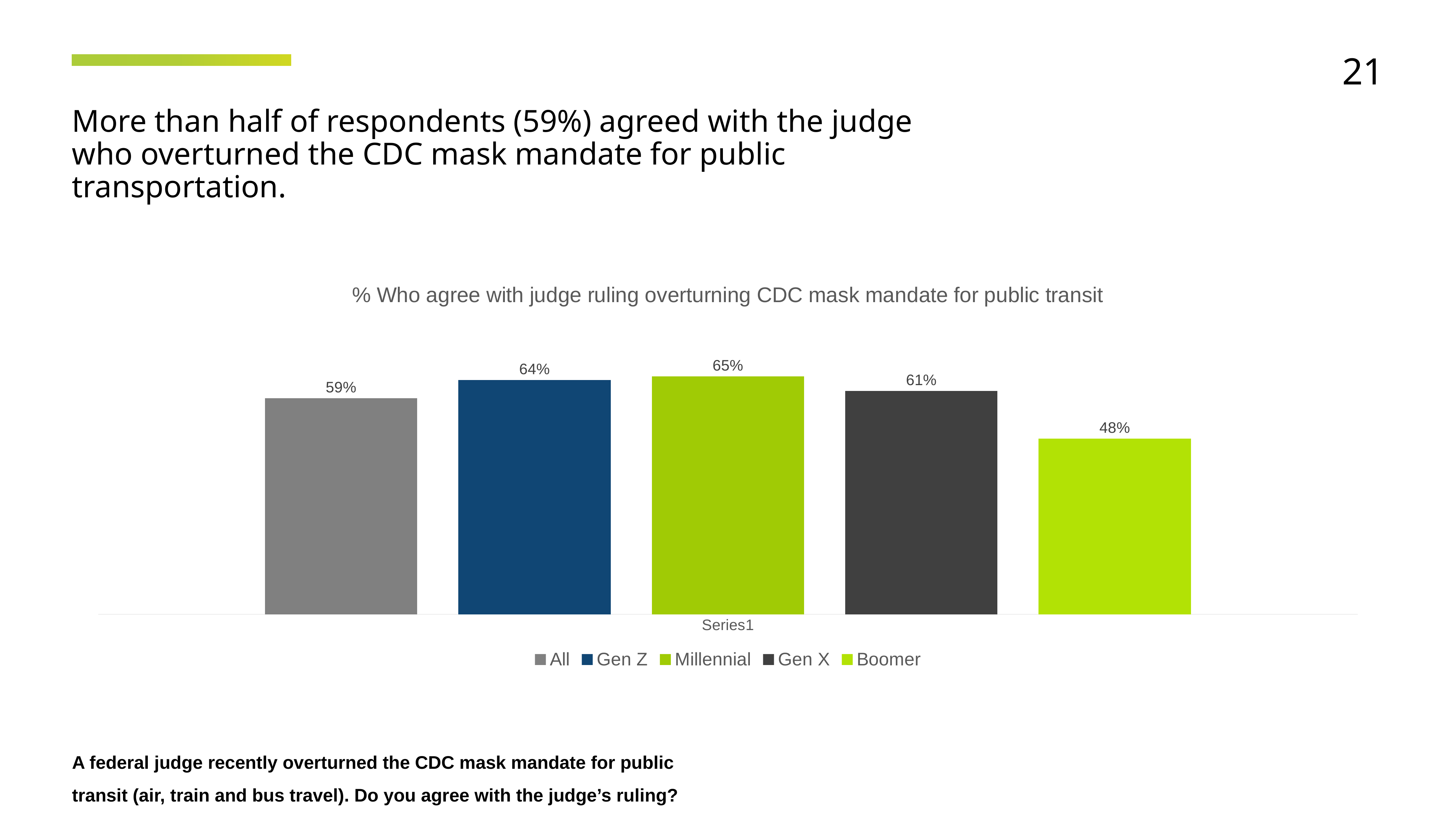
What is the value shown for Boomer in the chart? 48% Which is larger, the value for Gen X or the value for Boomer? Gen X What is the difference between the Millennial and Boomer values? 17% What is the difference between the Gen Z and All values? 5% Which group has the highest percentage agreeing with the judge's ruling? Millennial What percentage of Gen Z respondents agree with the judge ruling overturning the CDC mask mandate for public transit? 64% What kind of chart is shown on the slide? Bar chart What is the value shown for All respondents in the chart? 59% Which group has the lowest percentage agreeing with the judge's ruling? Boomer What is the value shown for Gen X in the chart? 61% How many series does the legend list? 5 What is the title of the chart? % Who agree with judge ruling overturning CDC mask mandate for public transit